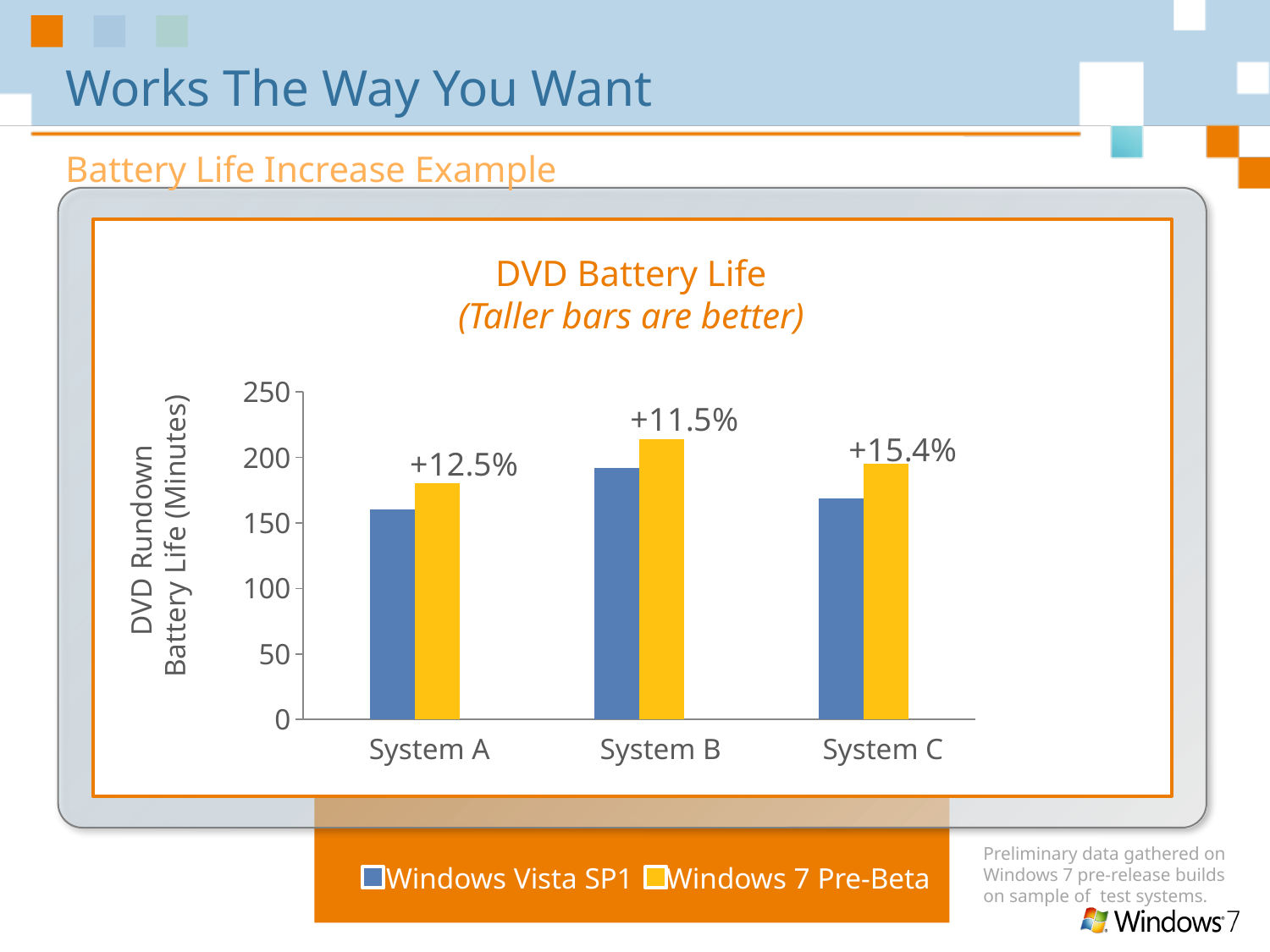
Which series is shown in yellow in the DVD Battery Life chart? Windows 7 Pre-Beta Is the Windows 7 Pre-Beta value for System B greater or less than 200 minutes? greater How many series does the legend of the DVD Battery Life chart list? 2 What percentage increase is labelled above the bars for System A? +12.5% Which system shows the largest labelled percentage increase in DVD battery life? System C Which system has the tallest Windows 7 Pre-Beta bar? System B What percentage increase is labelled above the bars for System B? +11.5% Which system shows the smallest labelled percentage increase in DVD battery life? System B What percentage increase is labelled above the bars for System C? +15.4% How many systems are shown on the x axis of the DVD Battery Life chart? 3 Is the Windows Vista SP1 value for System A greater or less than 200 minutes? less What kind of chart is shown on the slide? bar chart